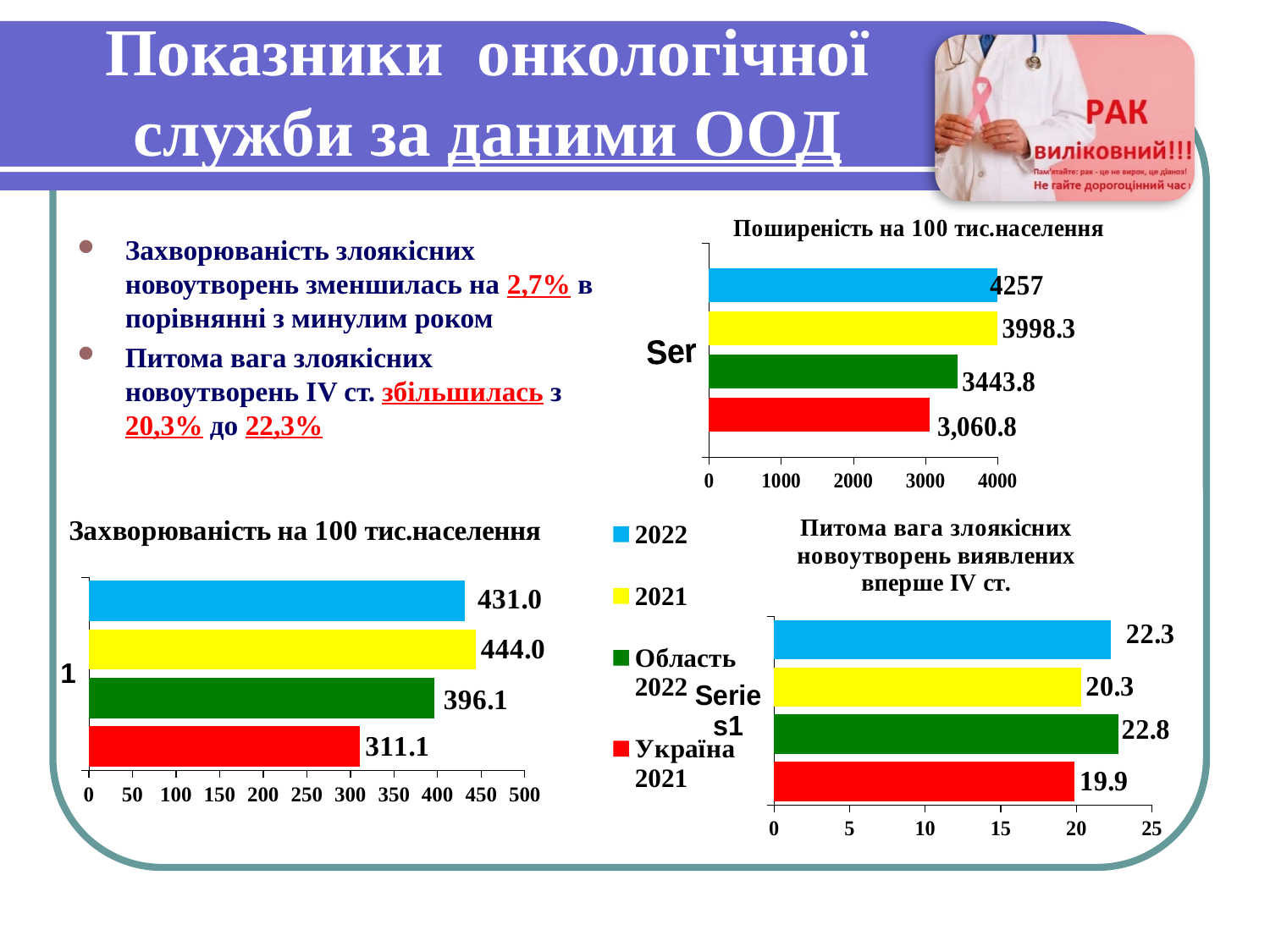
In the chart 'Питома вага злоякісних новоутворень виявлених вперше IV ст.', what is the value of the green bar (Область 2022)? 22.8 In the chart 'Поширеність на 100 тис.населення', which series has the lowest value? Україна 2021 In the chart 'Поширеність на 100 тис.населення', what is the value of the blue bar (2022)? 4257 In the chart 'Поширеність на 100 тис.населення', what is the value of the red bar (Україна 2021)? 3,060.8 In the chart 'Захворюваність на 100 тис.населення', what is the difference between the 2021 value and the 2022 value? 13.0 In the chart 'Захворюваність на 100 тис.населення', is the value for Україна 2021 greater or less than 300? greater In the chart 'Захворюваність на 100 тис.населення', what is the value of the yellow bar (2021)? 444.0 In the chart 'Захворюваність на 100 тис.населення', which series has the highest value? 2021 How many series does the shared legend list? 4 In the chart 'Питома вага злоякісних новоутворень виявлених вперше IV ст.', which is larger: the 2022 value or the 2021 value? 2022 In the chart 'Питома вага злоякісних новоутворень виявлених вперше IV ст.', what is the difference between the 2022 value and the 2021 value? 2.0 What type of chart is 'Поширеність на 100 тис.населення'? bar chart